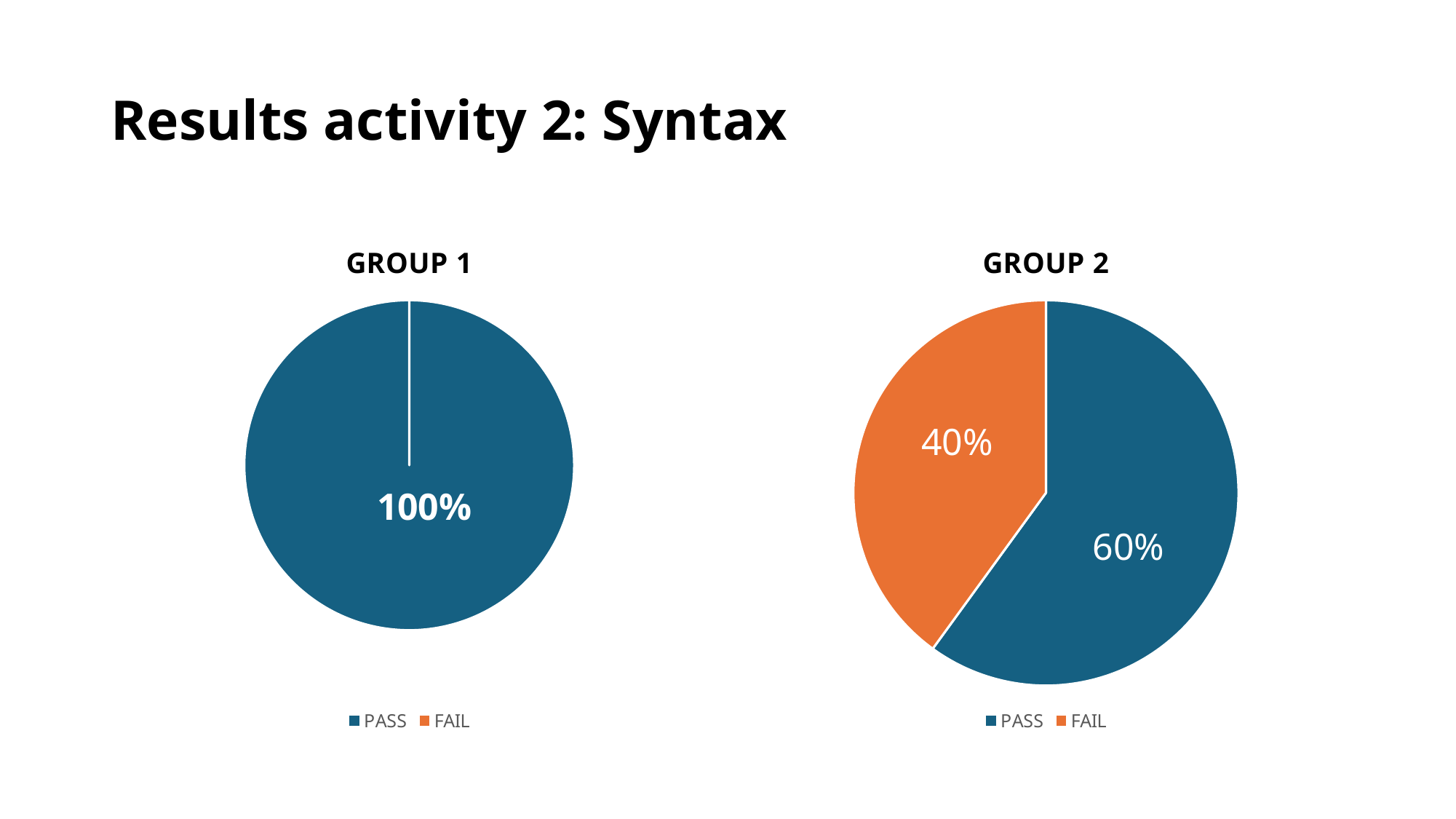
What is the title of the chart on the right? GROUP 2 In the GROUP 2 chart, what percentage is shown for FAIL? 40% In the GROUP 1 chart, what percentage is shown for PASS? 100% What type of chart is the GROUP 1 chart? Pie chart In the GROUP 2 chart, what colour is the FAIL slice? Orange How many entries does the legend of the GROUP 2 chart list? 2 Is the PASS share in the GROUP 2 chart greater or less than the PASS share in the GROUP 1 chart? less In the GROUP 2 chart, what percentage is shown for PASS? 60% How many charts are shown on the slide? 2 In the GROUP 2 chart, which category has the smallest slice? FAIL In the GROUP 2 chart, which category has the larger share, PASS or FAIL? PASS In the GROUP 2 chart, what is the difference in percentage points between PASS and FAIL? 20